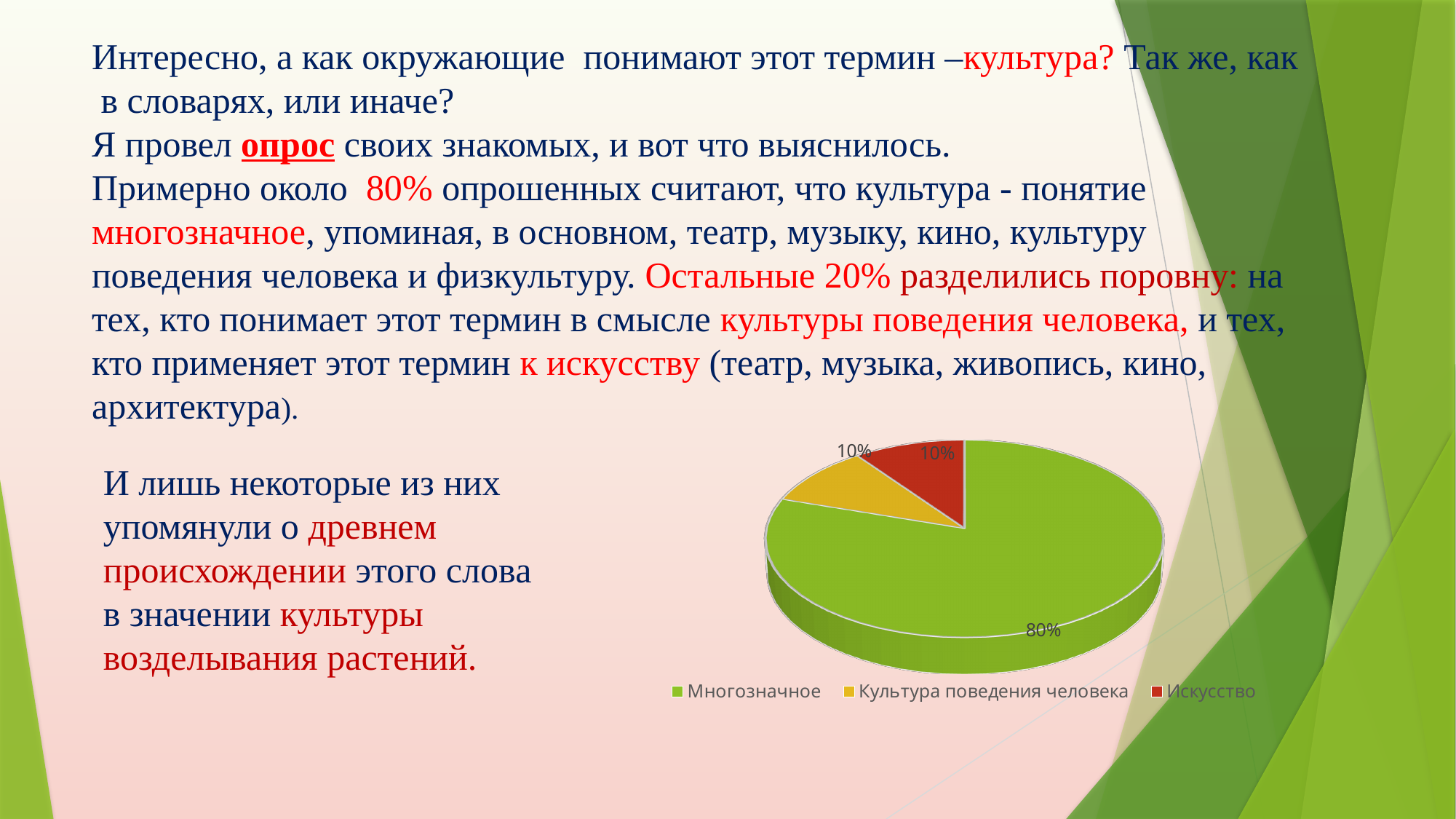
What is the difference between the share for "Многозначное" and the share for "Искусство"? 70% What colour is the slice for "Искусство"? red What share of the pie does "Культура поведения человека" take? 10% What share of the pie does "Многозначное" take? 80% What kind of chart is shown on the slide? pie chart How many entries does the legend list? 3 How many slices does the pie chart have? 3 Which category has the largest slice of the pie? Многозначное What colour is the slice for "Многозначное"? green What share of the pie does "Искусство" take? 10% What is the combined share of "Культура поведения человека" and "Искусство"? 20% Which is larger: the slice for "Многозначное" or the slice for "Культура поведения человека"? Многозначное